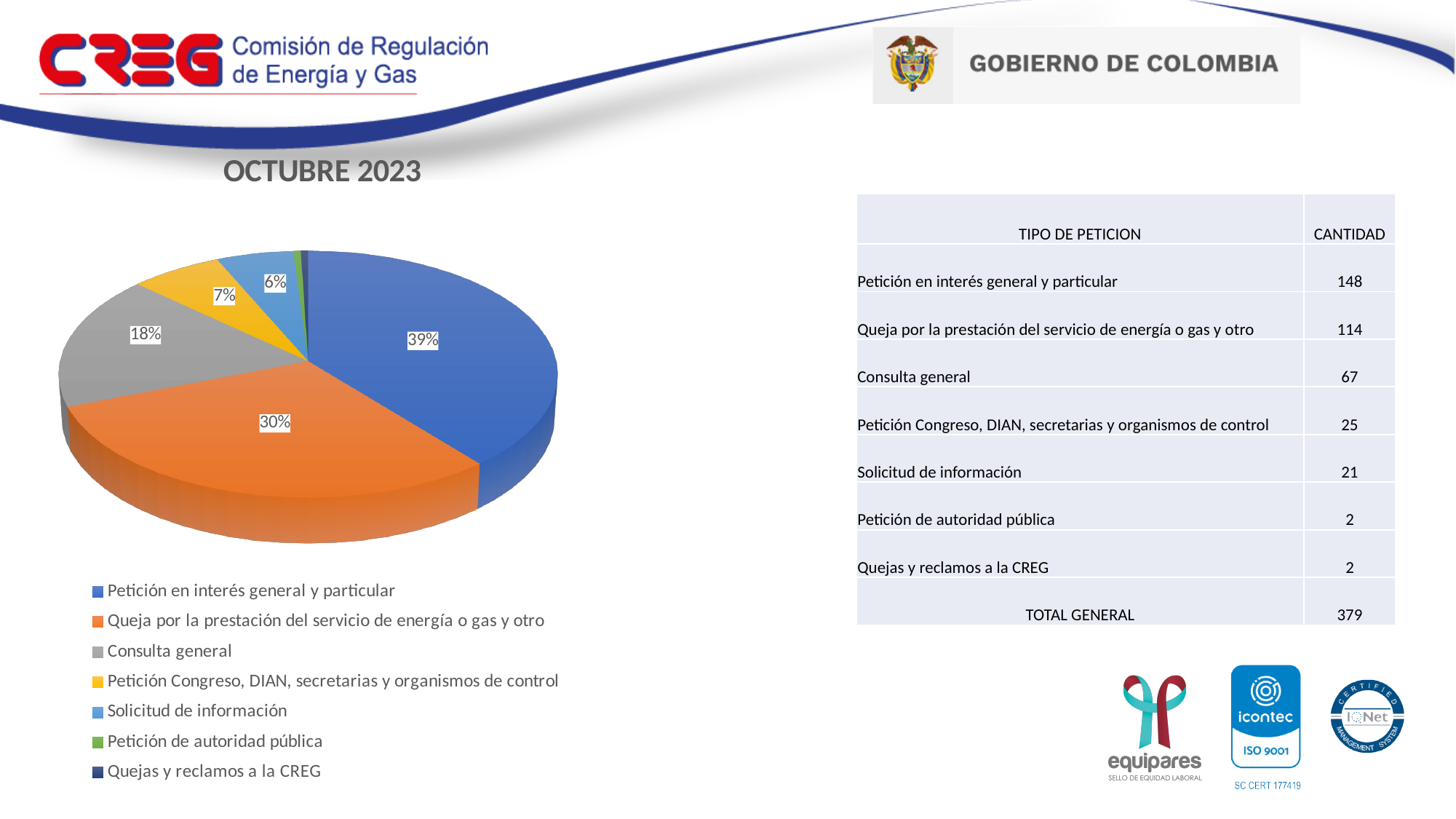
What is the difference in percentage points between the 'Petición en interés general y particular' slice and the 'Queja por la prestación del servicio de energía o gas y otro' slice? 9 percentage points What share of the pie does 'Petición Congreso, DIAN, secretarias y organismos de control' represent? 7% What share of the pie does 'Petición en interés general y particular' represent? 39% What type of chart is shown on the slide? Pie chart Which category has the largest slice of the pie? Petición en interés general y particular What share of the pie does 'Solicitud de información' represent? 6% Which slice is larger: 'Consulta general' or 'Solicitud de información'? Consulta general What is the title of the chart? OCTUBRE 2023 What colour is the slice for 'Consulta general'? Gray How many entries does the chart legend list? 7